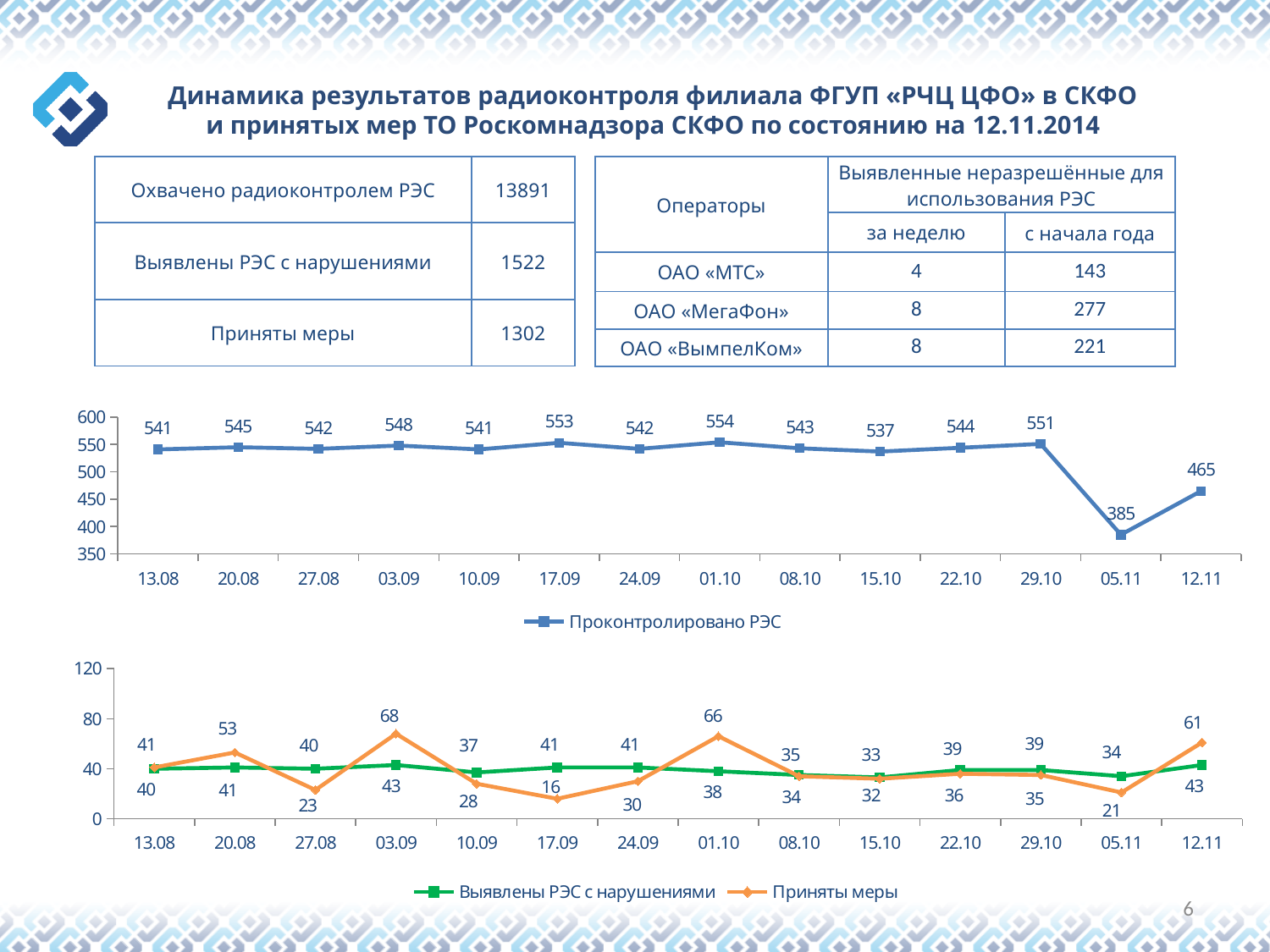
In the bottom chart, what is the value of Приняты меры on 03.09? 68 In the top chart, what is the difference between the values on 29.10 and 05.11? 166 In the top chart, on which date is Проконтролировано РЭС lowest? 05.11 In the top chart, on which date is Проконтролировано РЭС highest? 01.10 In the top chart, what is the value of Проконтролировано РЭС on 05.11? 385 In the bottom chart, on which date is Приняты меры lowest? 17.09 In the bottom chart, which is larger on 12.11: Выявлены РЭС с нарушениями or Приняты меры? Приняты меры In the bottom chart, how many series does the legend list? 2 In the top chart, what is the value of Проконтролировано РЭС on 01.10? 554 In the top chart, how many dates are plotted on the x axis? 14 What kind of chart is the bottom chart? line chart In the top chart, is the value on 12.11 greater or less than 500? less